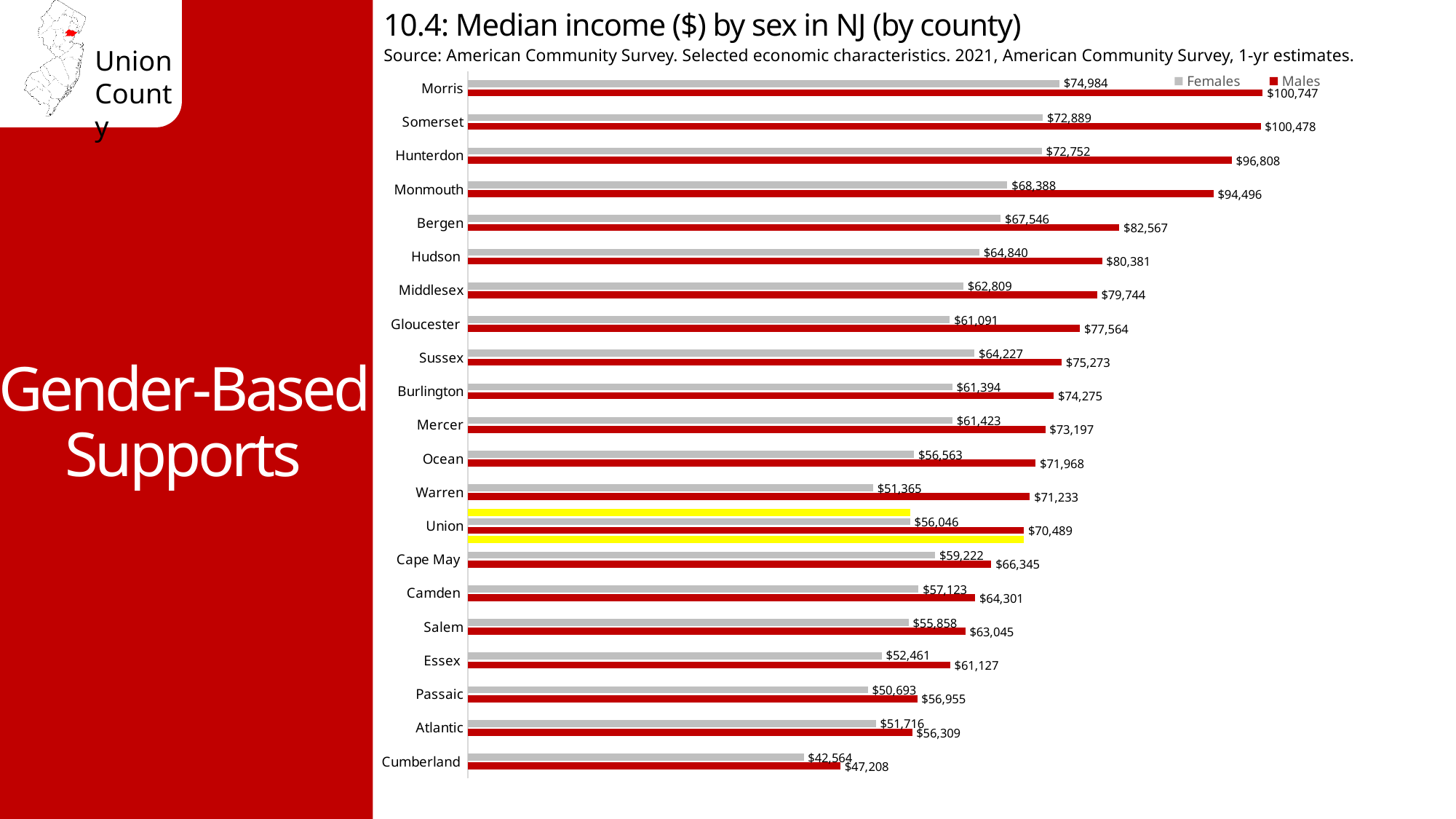
What is the difference between male and female median income in Morris County? $25,763 What is the median income for males in Cumberland County? $47,208 What is the median income for females in Bergen County? $67,546 Which is larger, the female median income in Sussex or in Gloucester? Sussex How many counties are shown in the chart? 21 What is the median income for females in Union County? $56,046 Which county has the lowest median income for females? Cumberland How many series does the legend list? 2 What is the difference between male and female median income in Union County? $14,443 What kind of chart is shown on the slide? Bar chart Which county has the highest median income for males? Morris What is the median income for males in Union County? $70,489